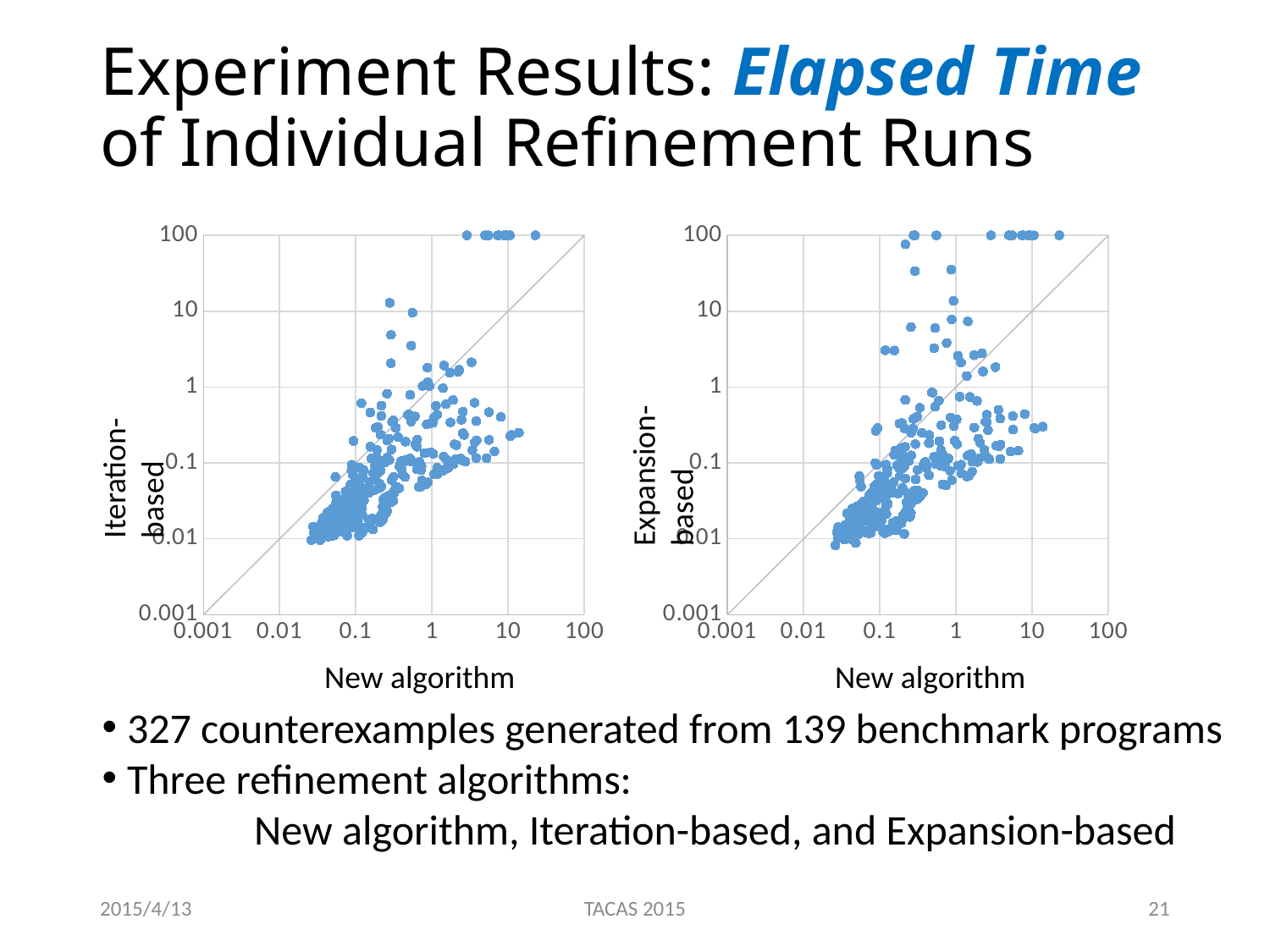
What kind of chart is the left chart (Iteration-based vs New algorithm)? scatter chart What kind of chart is the right chart (Expansion-based vs New algorithm)? scatter chart What is the label of the y axis on the right chart? Expansion-based What is the label of the x axis on the left chart? New algorithm On the right chart, what is the lowest value shown on the x axis? 0.001 On the left chart, what is the highest value shown on the y axis? 100 In the left chart, do the Iteration-based values generally rise or fall as the New algorithm value increases along the x axis? rise In the right chart, do the Expansion-based values generally rise or fall as the New algorithm value increases along the x axis? rise